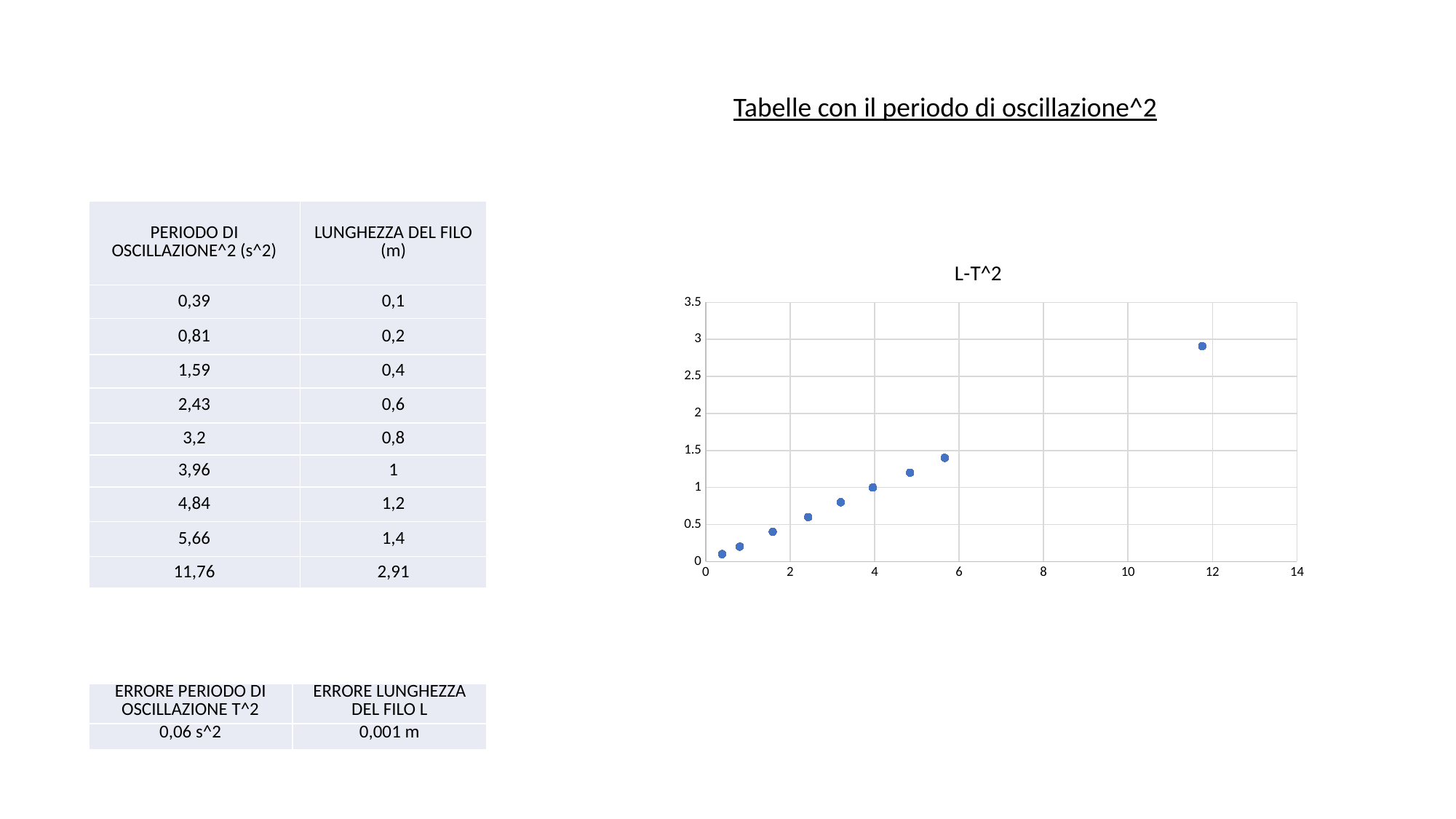
In the L-T^2 chart, is the y value of the leftmost point greater or less than 0.5? less In the L-T^2 chart, do the y values rise or fall as x increases? rise In the L-T^2 chart, how many points have an x value less than 6? 8 In the L-T^2 chart, is the y value of the point with the second-largest x value greater or less than 2? less What is the title of the chart on the slide? L-T^2 What kind of chart is the L-T^2 chart? scatter chart In the L-T^2 chart, is the x value of the rightmost point greater or less than 10? greater In the L-T^2 chart, which point has the highest y value? the rightmost point How many data points are plotted in the L-T^2 chart? 9 What is the highest tick value shown on the x axis of the L-T^2 chart? 14